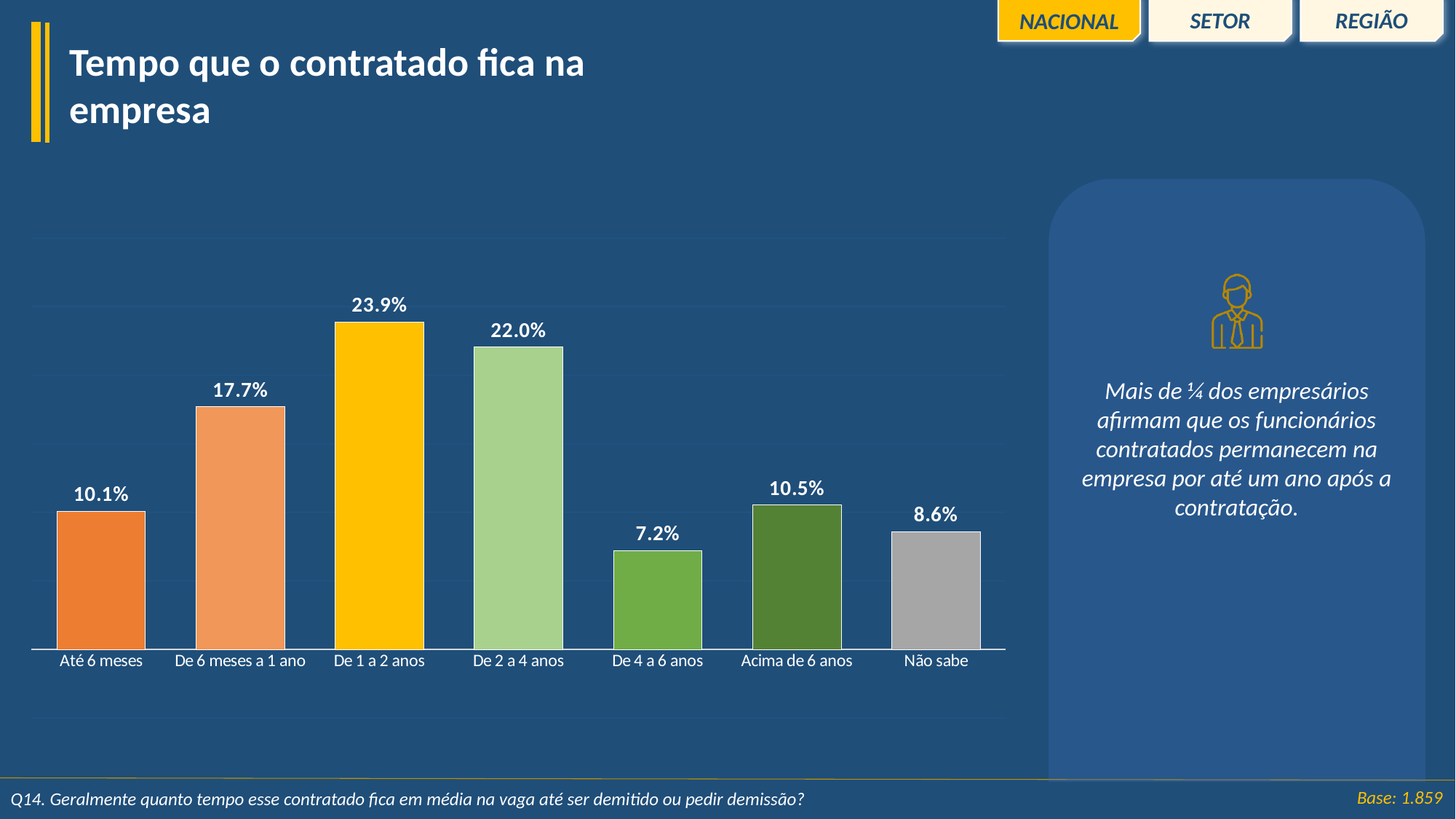
What is the difference between 'De 6 meses a 1 ano' and 'Até 6 meses'? 7.6% Which category has the highest value? De 1 a 2 anos What kind of chart is shown on the slide? Bar chart What is the value for 'Não sabe'? 8.6% Which category has the lowest value? De 4 a 6 anos What is the difference between 'De 1 a 2 anos' and 'De 2 a 4 anos'? 1.9% What is the value for 'De 1 a 2 anos'? 23.9% What is the value for 'Até 6 meses'? 10.1% What is the combined value of 'Até 6 meses' and 'De 6 meses a 1 ano'? 27.8% Which is larger, 'Acima de 6 anos' or 'Não sabe'? Acima de 6 anos How many categories are shown on the x axis? 7 What is the title of the chart? Tempo que o contratado fica na empresa